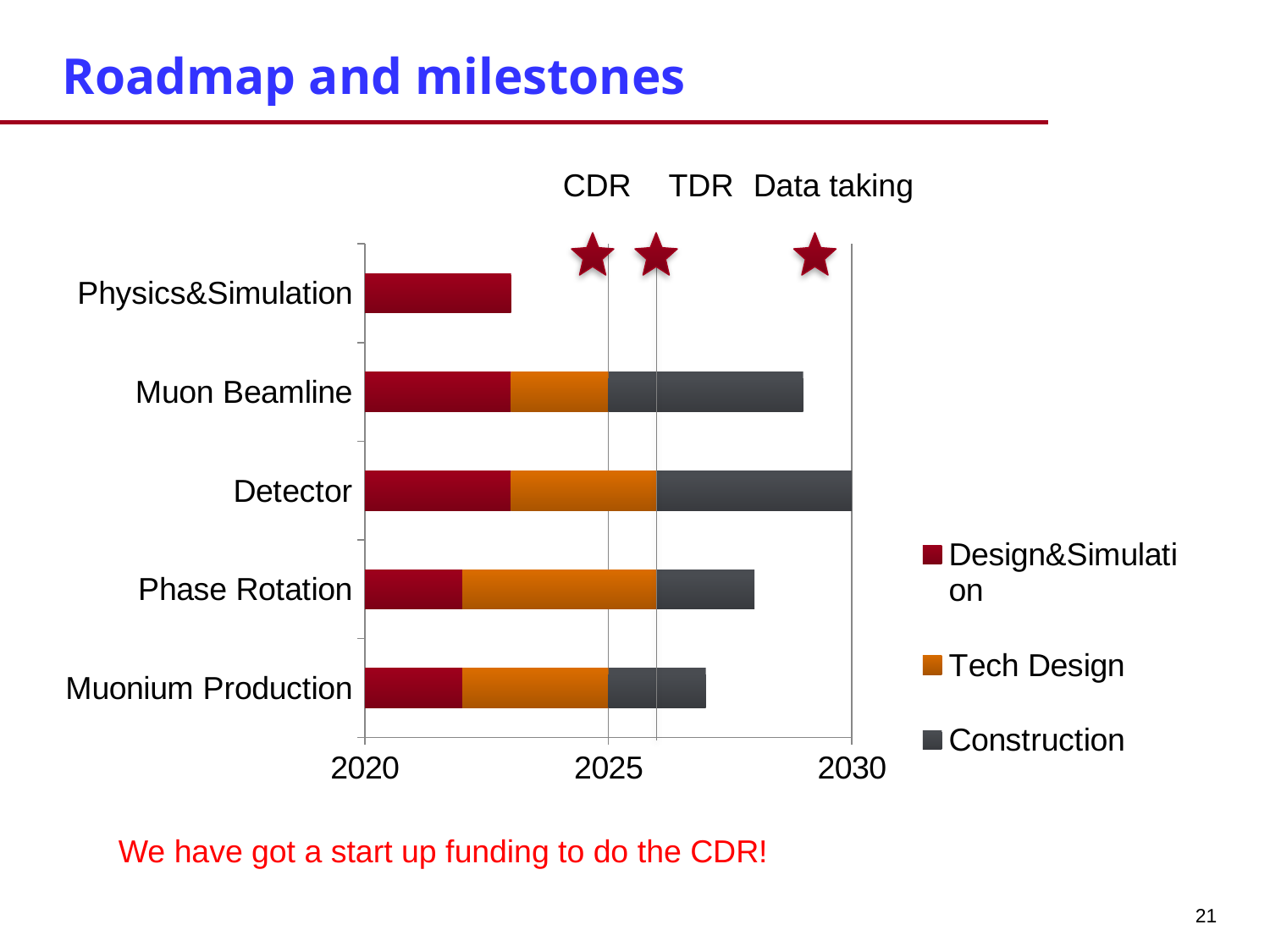
Is the end of the Muon Beamline bar greater or less than 2025? greater Which bar extends further to the right, Detector or Muonium Production? Detector Is the end of the Phase Rotation bar greater or less than 2030? less Is the end of the Physics&Simulation bar greater or less than 2025? less Which category has the shortest bar in the chart? Physics&Simulation What kind of chart is shown on the slide? bar chart How many series does the chart legend list? 3 What are the three milestones marked with stars above the chart? CDR, TDR, Data taking Which category's bar consists only of the Design&Simulation segment? Physics&Simulation Which bar extends further to the right, Muon Beamline or Phase Rotation? Muon Beamline How many categories are plotted on the vertical axis of the chart? 5 Which category's bar extends furthest to the right along the year axis? Detector